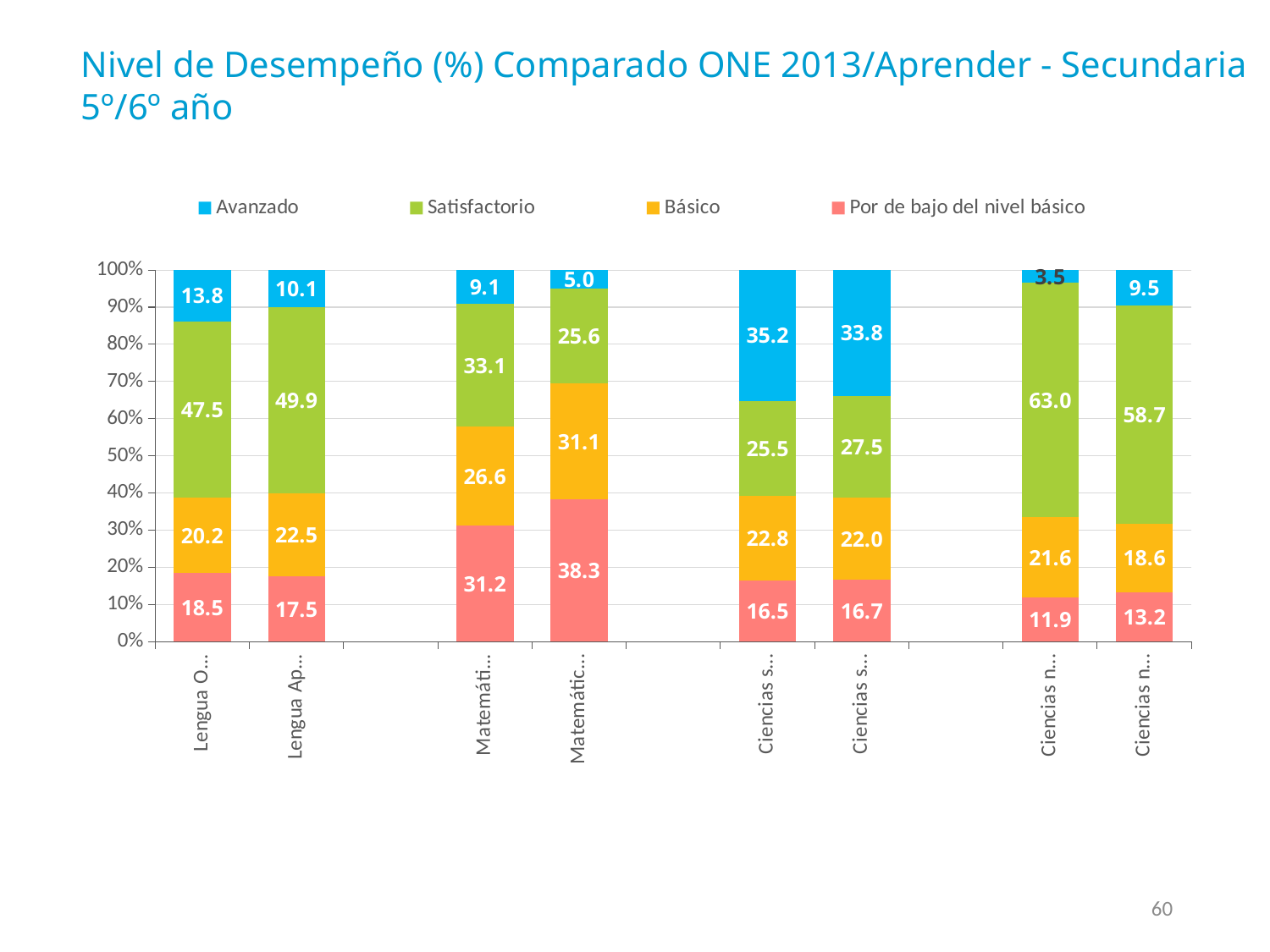
How many series does the legend list? 4 Which bar has the highest 'Por de bajo del nivel básico' value? The fourth bar from the left (38.3) What is the Básico value for the fourth bar from the left? 31.1 How many stacked bars are plotted in the chart? 8 What is the Avanzado value for the fifth bar from the left? 35.2 Which bar has the lowest Avanzado value? The seventh bar from the left (3.5) What is the Satisfactorio value for the seventh bar from the left? 63.0 Which has the larger Satisfactorio value, the first bar or the second bar from the left? The second bar (49.9) Which bar has the highest Avanzado value? The fifth bar from the left (35.2) What is the difference between the 'Por de bajo del nivel básico' values of the fourth bar (38.3) and the third bar (31.2)? 7.1 What kind of chart is shown on the slide? Stacked bar chart What colour represents the Avanzado series in the legend? Blue